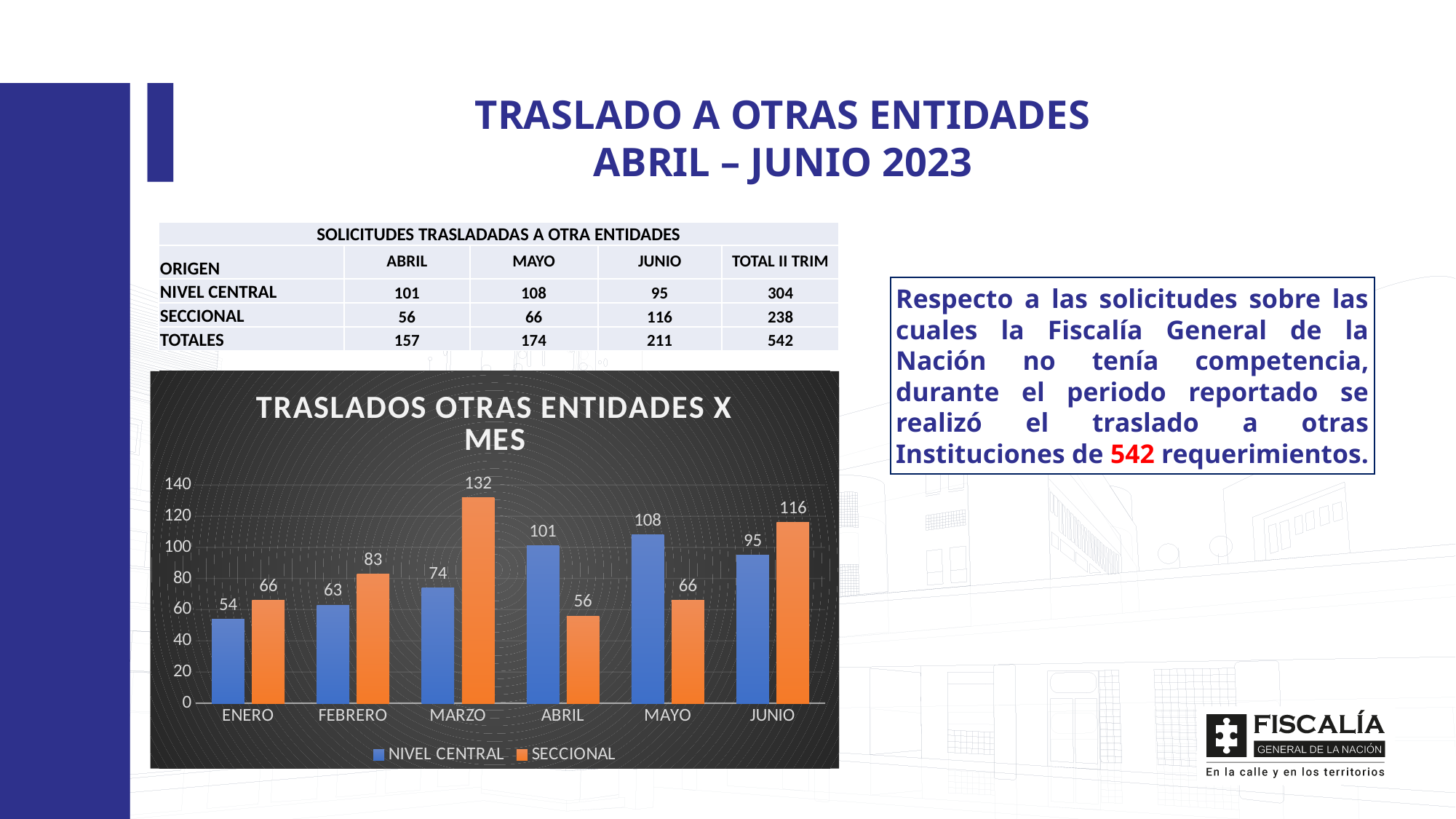
Is the SECCIONAL value for JUNIO greater or less than 100? greater What is the difference between the SECCIONAL and NIVEL CENTRAL values in MARZO? 58 Which month has the lowest NIVEL CENTRAL value? ENERO How many series does the chart legend list? 2 Which month has the highest SECCIONAL value? MARZO What is the value for SECCIONAL in ENERO? 66 What kind of chart is shown on the slide? bar chart What is the value for NIVEL CENTRAL in MAYO? 108 How many months are shown on the x axis of the chart? 6 In ABRIL, which series has the larger value, NIVEL CENTRAL or SECCIONAL? NIVEL CENTRAL What is the title of the chart? TRASLADOS OTRAS ENTIDADES X MES What is the value for SECCIONAL in MARZO? 132